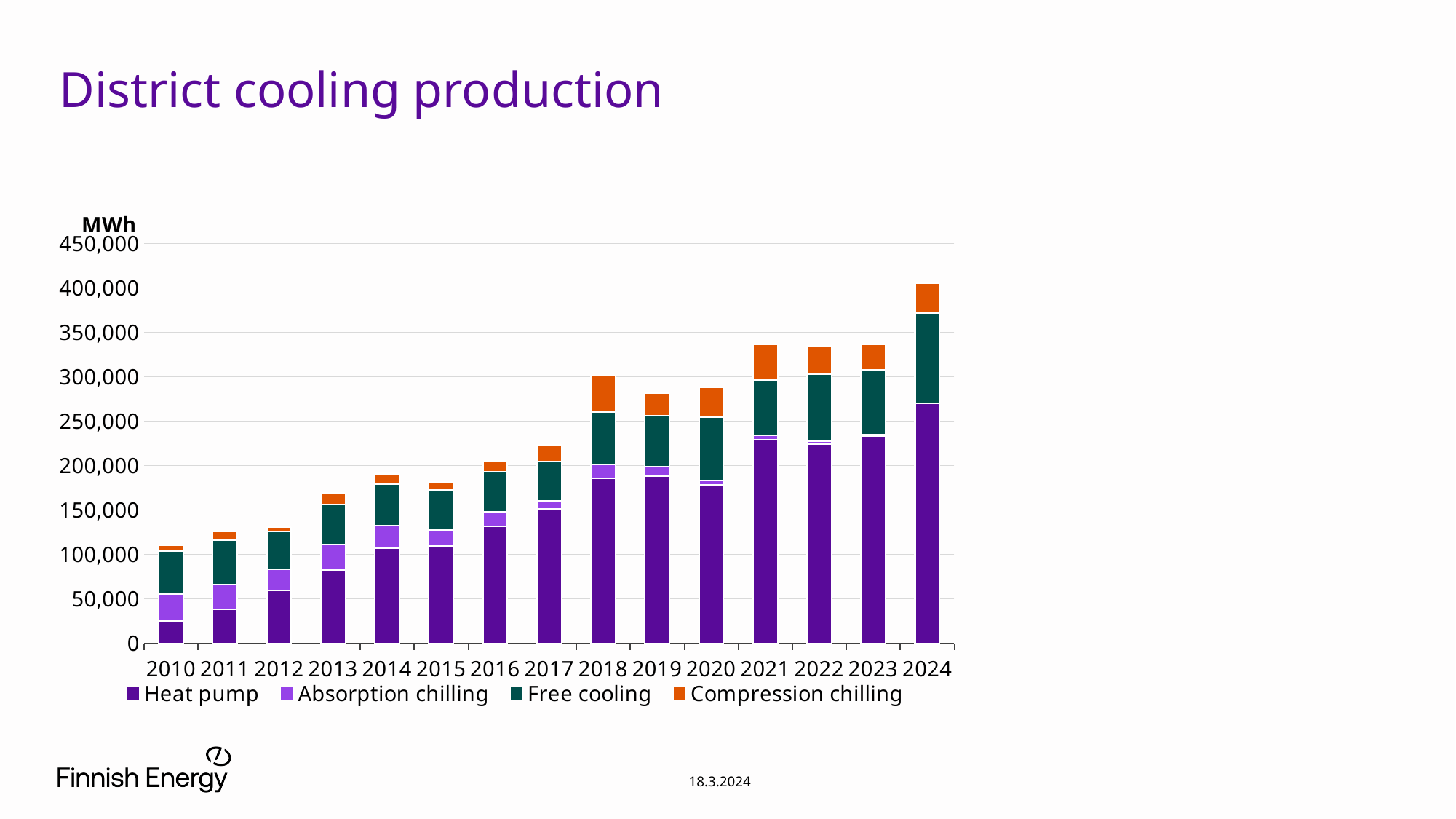
Which year has the larger total production, 2018 or 2019? 2018 Is the total production for 2024 greater or less than 350,000 MWh? greater Which year has the lowest total district cooling production? 2010 Is the total production for 2010 greater or less than 150,000 MWh? less What is the title of the chart on the slide? District cooling production Is the Heat pump value for 2021 greater or less than 200,000 MWh? greater How many series does the legend list? 4 What kind of chart is shown on the slide? Stacked bar chart Which year has the highest total district cooling production? 2024 Does total district cooling production generally rise or fall from 2010 to 2024? rise How many years are shown on the x axis of the chart? 15 What unit is shown on the y axis of the chart? MWh